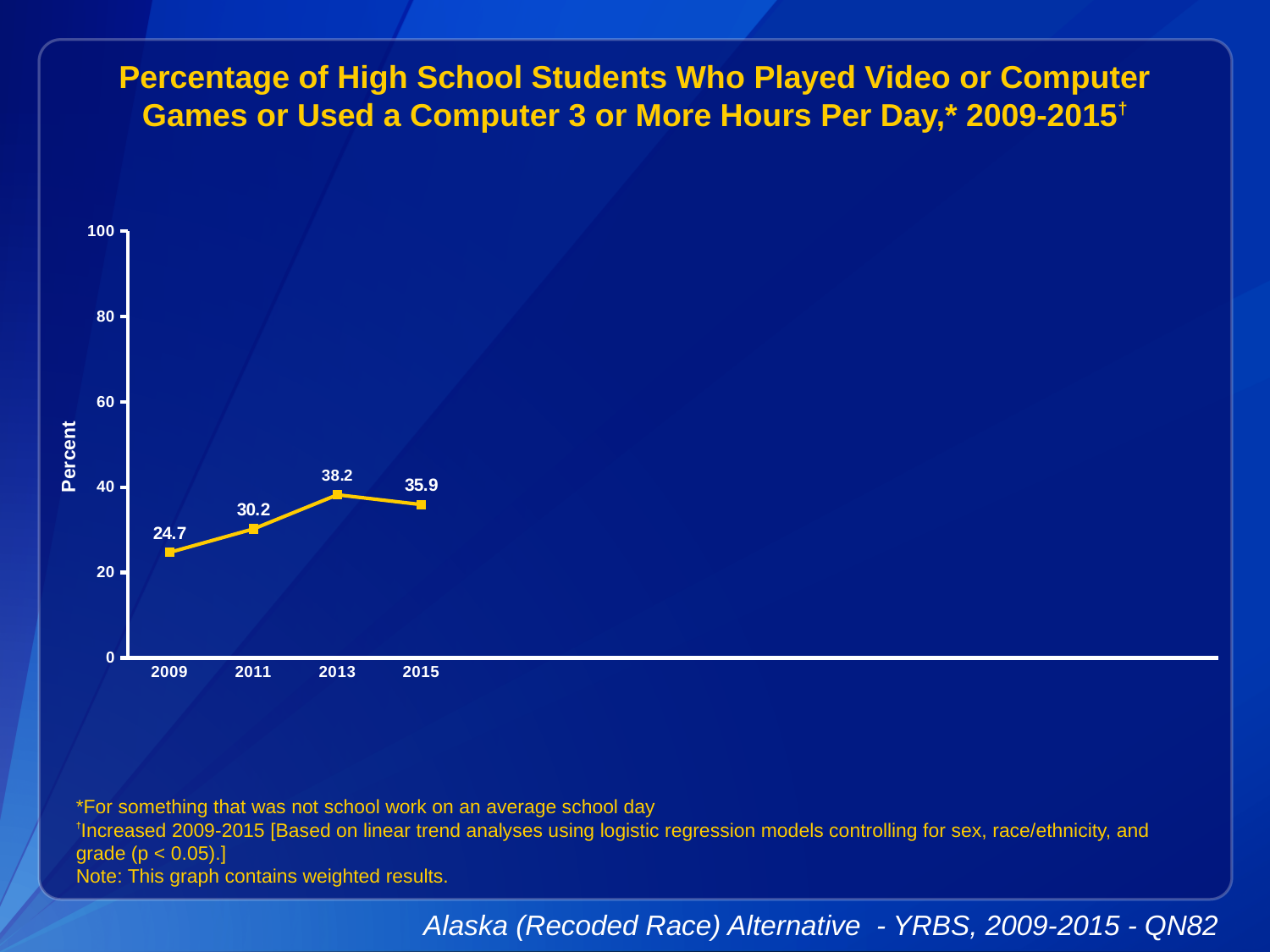
What is the value for 2015? 35.9 What is the value for 2013? 38.2 What is the value for 2009? 24.7 Do the values rise or fall from 2009 to 2013? rise Is the value for 2011 greater or less than 40? less Which year has the highest value? 2013 What kind of chart is shown? line chart How many years are plotted on the chart? 4 Which is larger, the value for 2011 or the value for 2015? 2015 What is the difference between the values for 2013 and 2009? 13.5 What is the label on the vertical axis? Percent Which year has the lowest value? 2009